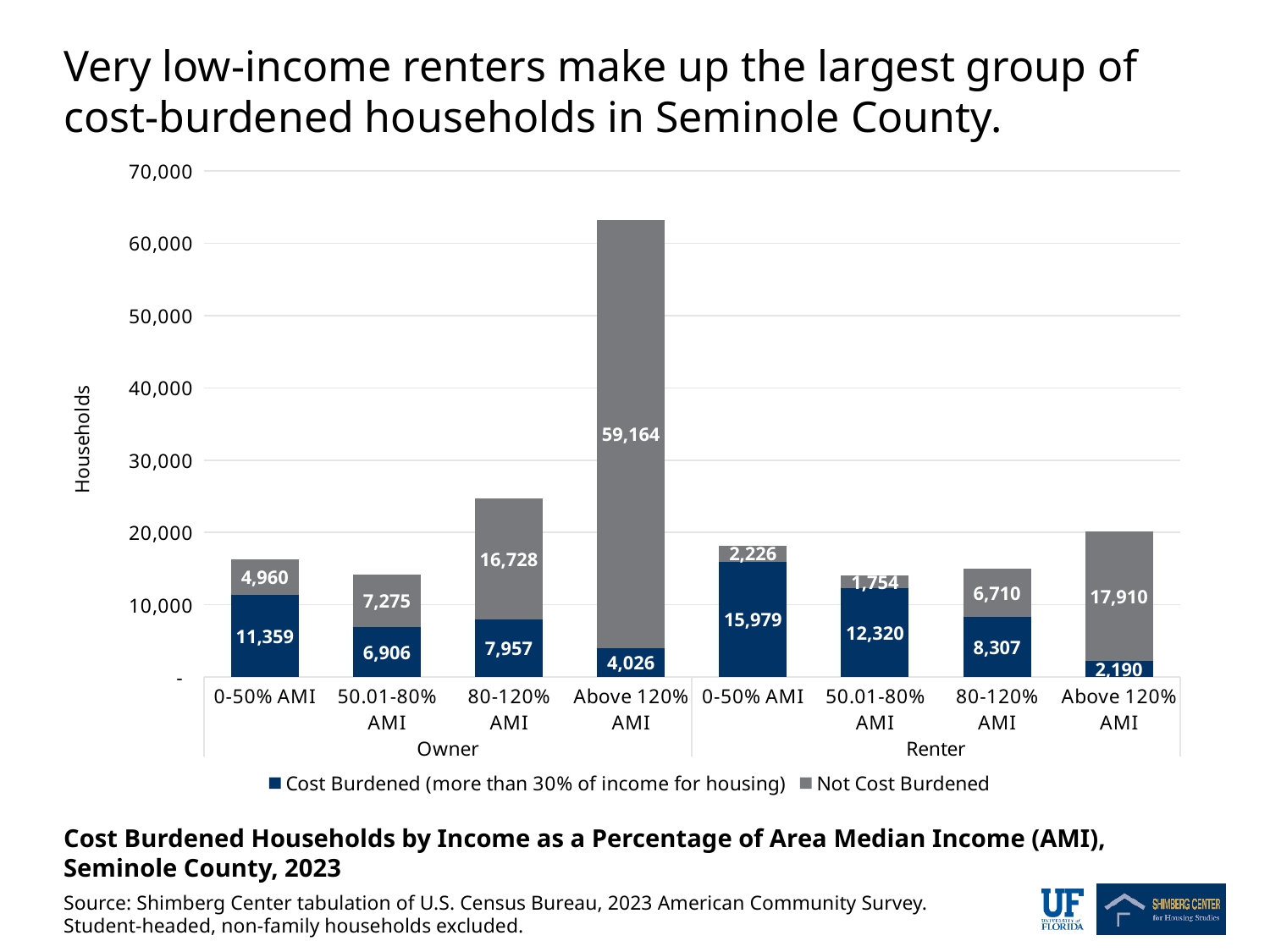
What is the difference between cost-burdened renter households at 0-50% AMI and cost-burdened owner households at 0-50% AMI? 4,620 How many income categories (bars) are plotted in the chart? 8 What is the total number of households in the Owner 0-50% AMI bar? 16,319 What is the number of not cost-burdened owner households above 120% AMI? 59,164 How many series does the legend list? 2 What is the number of cost-burdened renter households at 0-50% AMI? 15,979 What is the number of cost-burdened owner households at 50.01-80% AMI? 6,906 Which category has the lowest number of cost-burdened households? Renter Above 120% AMI What kind of chart is shown on the slide? Stacked bar chart Which is larger: the number of cost-burdened renter households at 50.01-80% AMI or the number of cost-burdened owner households at 80-120% AMI? Renter 50.01-80% AMI Which category has the highest number of cost-burdened households? Renter 0-50% AMI Is the total height of the Owner Above 120% AMI bar greater or less than 60,000? greater